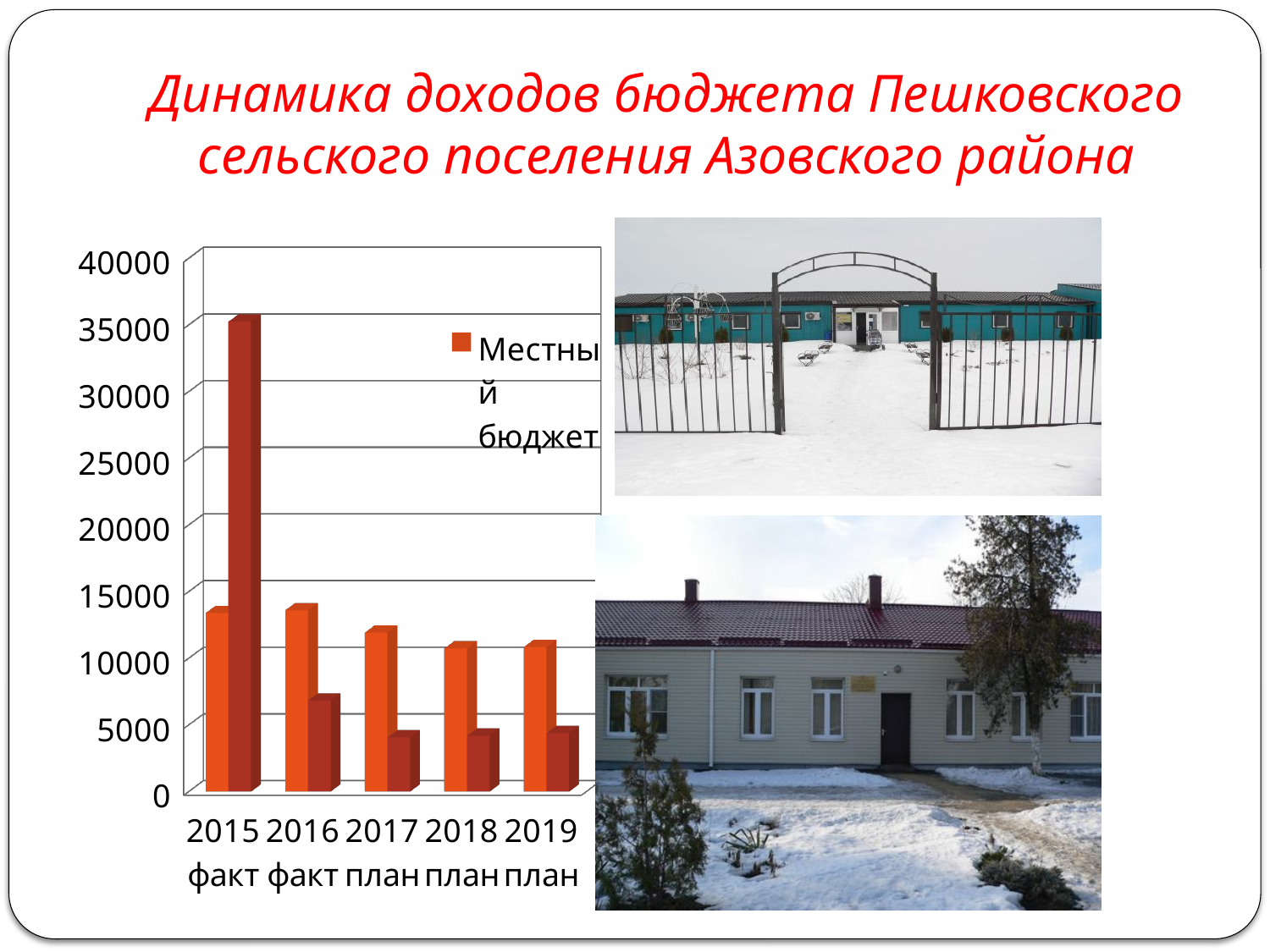
Is the value of Местный бюджет for 2015 факт greater or less than 10000? greater What is the title of the slide containing the chart? Динамика доходов бюджета Пешковского сельского поселения Азовского района Which series name is readable in the chart legend? Местный бюджет For which category is the dark red series highest? 2015 факт For 2015 факт, which is larger: the Местный бюджет bar or the dark red bar? the dark red bar Is the value of the dark red series for 2015 факт greater or less than 30000? greater What kind of chart is shown on the slide? bar chart For 2016 факт, which is larger: the Местный бюджет bar or the dark red bar? Местный бюджет Is the value of Местный бюджет for 2019 план greater or less than 15000? less Does the dark red series generally rise or fall from 2015 to 2019? fall How many categories are shown along the x axis of the chart? 5